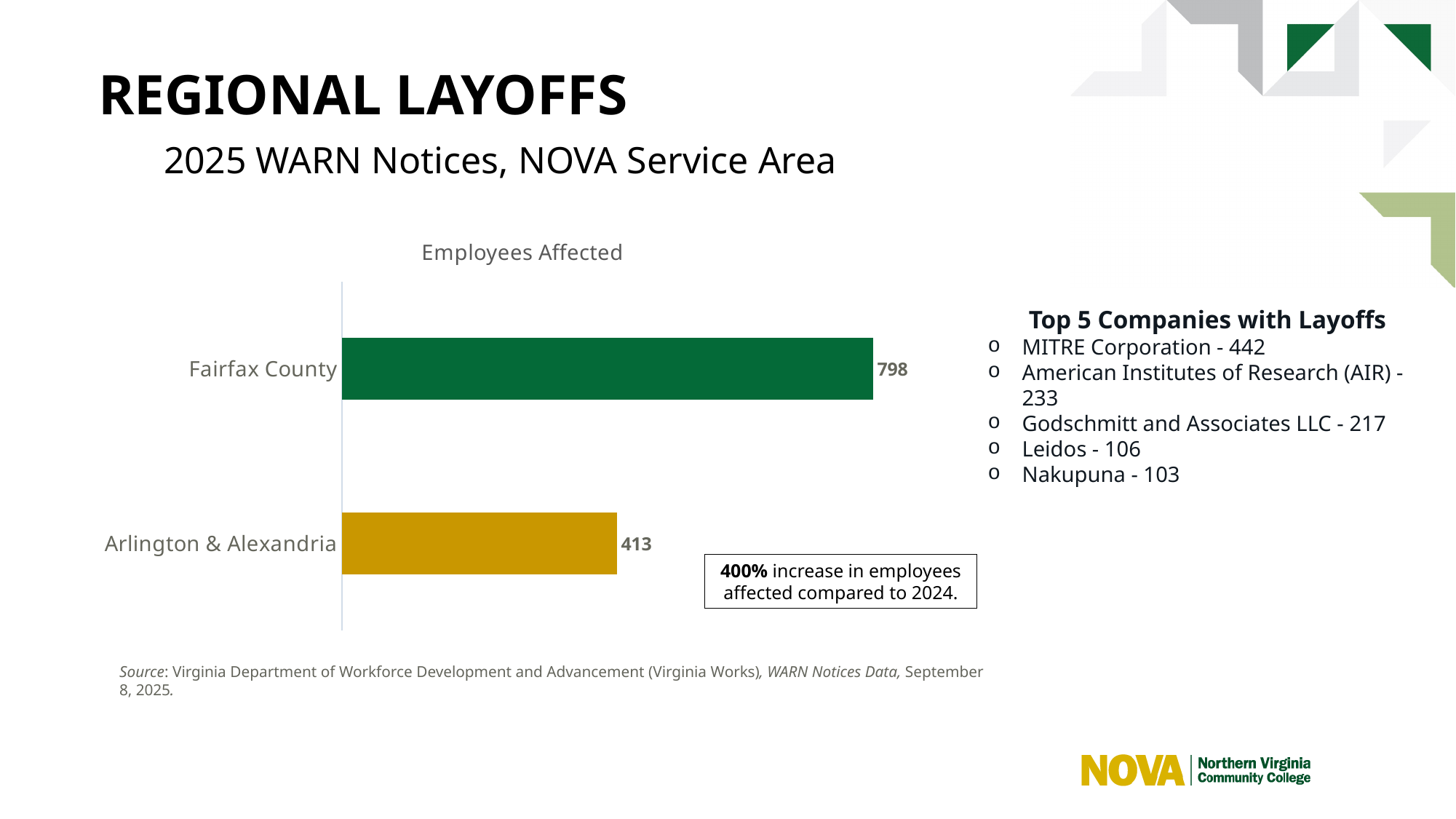
How many categories are shown in the Employees Affected chart? 2 What colour is the bar for Fairfax County? Green Which category has the highest number of employees affected? Fairfax County What is the difference in employees affected between Fairfax County and Arlington & Alexandria? 385 What is the total number of employees affected across both categories in the chart? 1211 What is the title of the chart? Employees Affected What kind of chart is used to show Employees Affected? Bar chart Which category has the lowest number of employees affected? Arlington & Alexandria Which has more employees affected, Fairfax County or Arlington & Alexandria? Fairfax County What is the value for Fairfax County in the Employees Affected chart? 798 What is the value for Arlington & Alexandria in the Employees Affected chart? 413